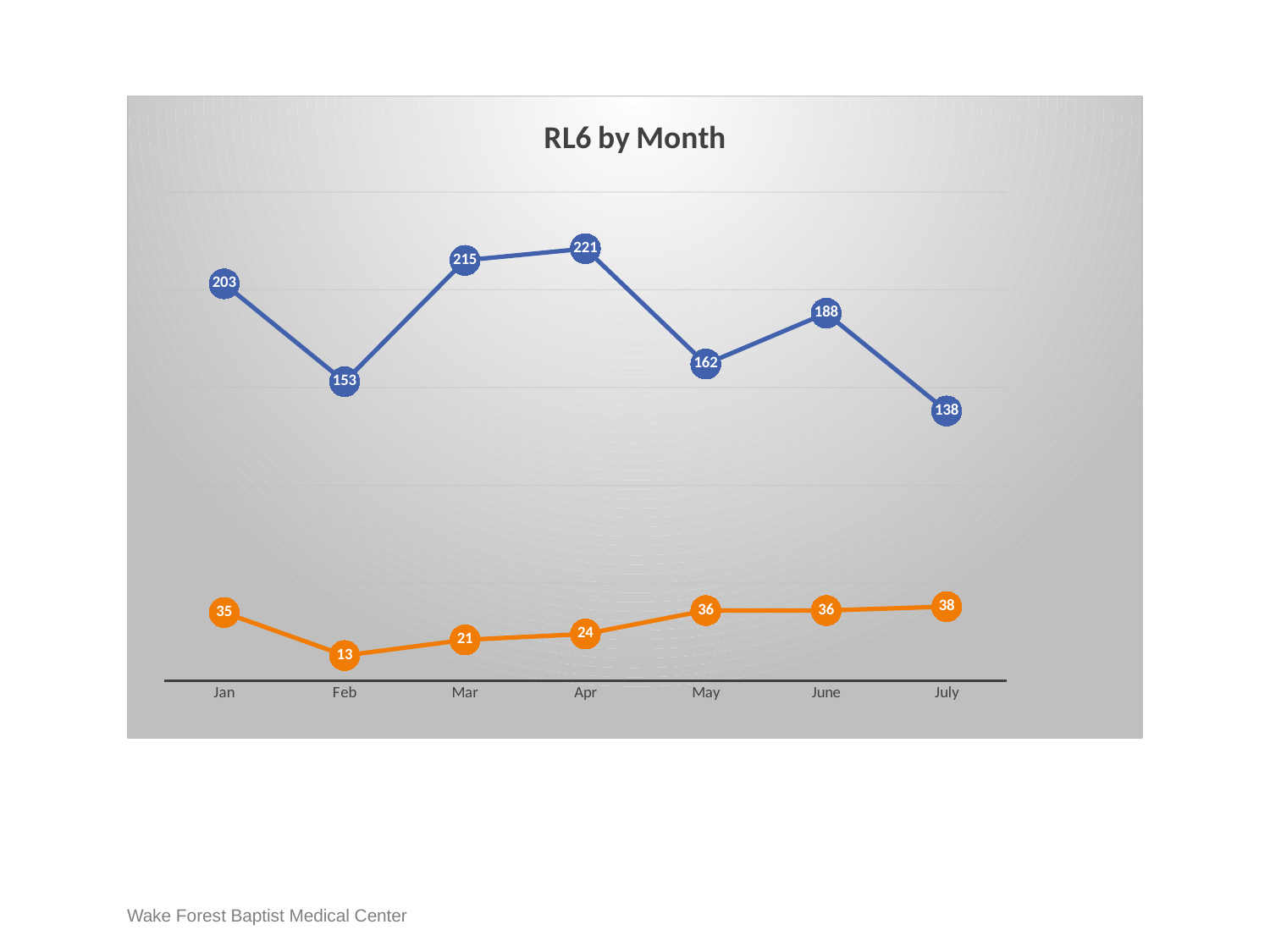
What is the title of the chart? RL6 by Month What kind of chart is shown on the slide? Line chart How many months are shown on the x axis? 7 What is the value of the blue line for July? 138 What is the value of the orange line for February? 13 What is the difference between the orange line's values for July and February? 25 In which month does the blue line reach its highest value? Apr What is the difference between the blue line's values for April and July? 83 In which month does the orange line have its lowest value? Feb What is the value of the blue line for April? 221 Does the orange line rise or fall from April to July? Rise Which is larger for the blue line: the value for March or the value for June? March